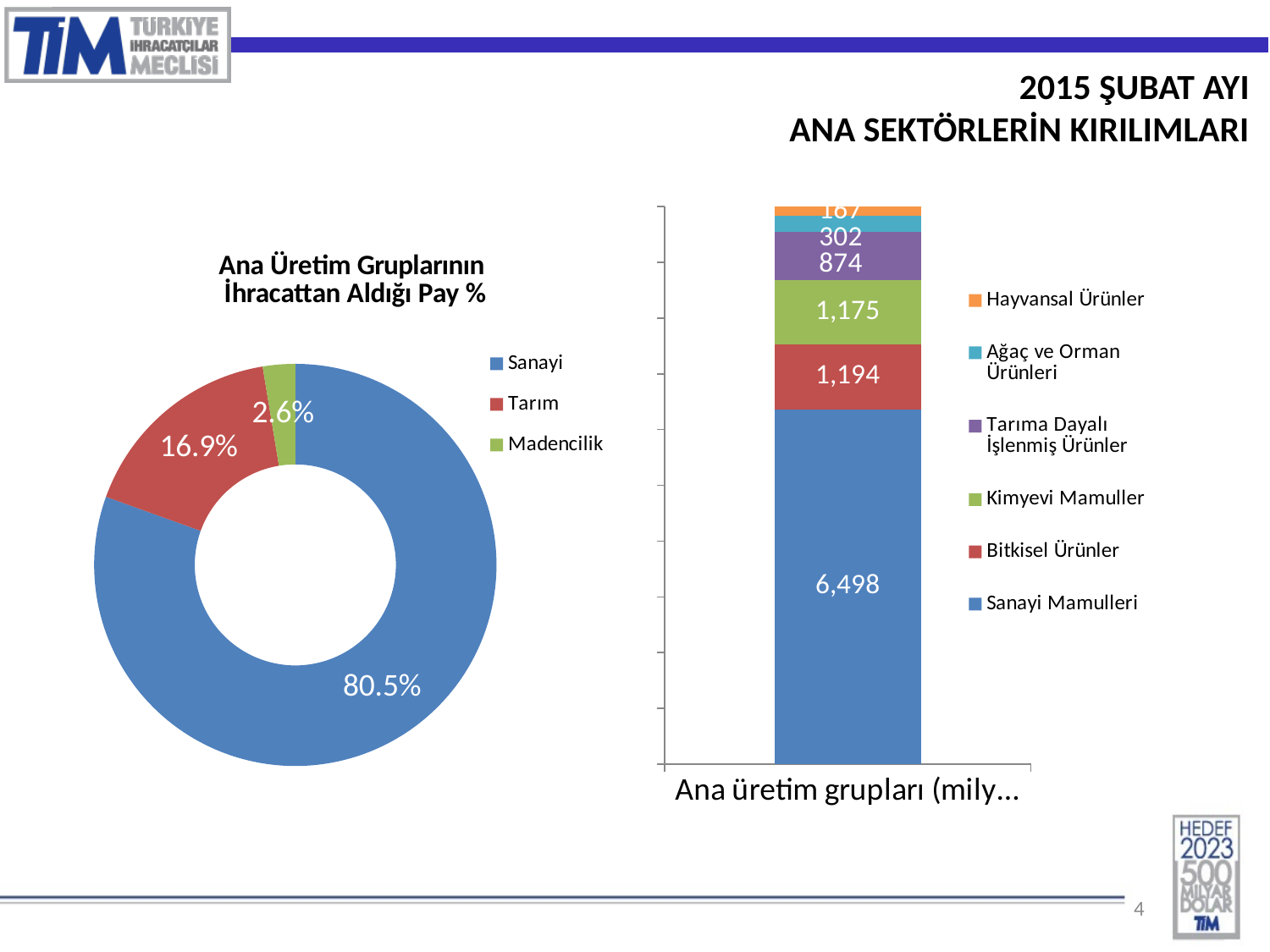
In the pie chart, which category has the largest share? Sanayi How many categories does the pie chart's legend list? 3 In the stacked bar chart on the right, what is the value for Sanayi Mamulleri? 6,498 In the stacked bar chart on the right, what is the value for Tarıma Dayalı İşlenmiş Ürünler? 874 In the pie chart, which category has the smallest share? Madencilik How many series does the legend of the stacked bar chart on the right list? 6 In the stacked bar chart on the right, what is the value for Kimyevi Mamuller? 1,175 In the pie chart, what is the difference between the shares of Tarım and Madencilik? 14.3% In the pie chart, what share does Sanayi have? 80.5% In the stacked bar chart on the right, which is larger: Bitkisel Ürünler or Ağaç ve Orman Ürünleri? Bitkisel Ürünler In the pie chart, what share does Tarım have? 16.9% In the pie chart, what share does Madencilik have? 2.6%